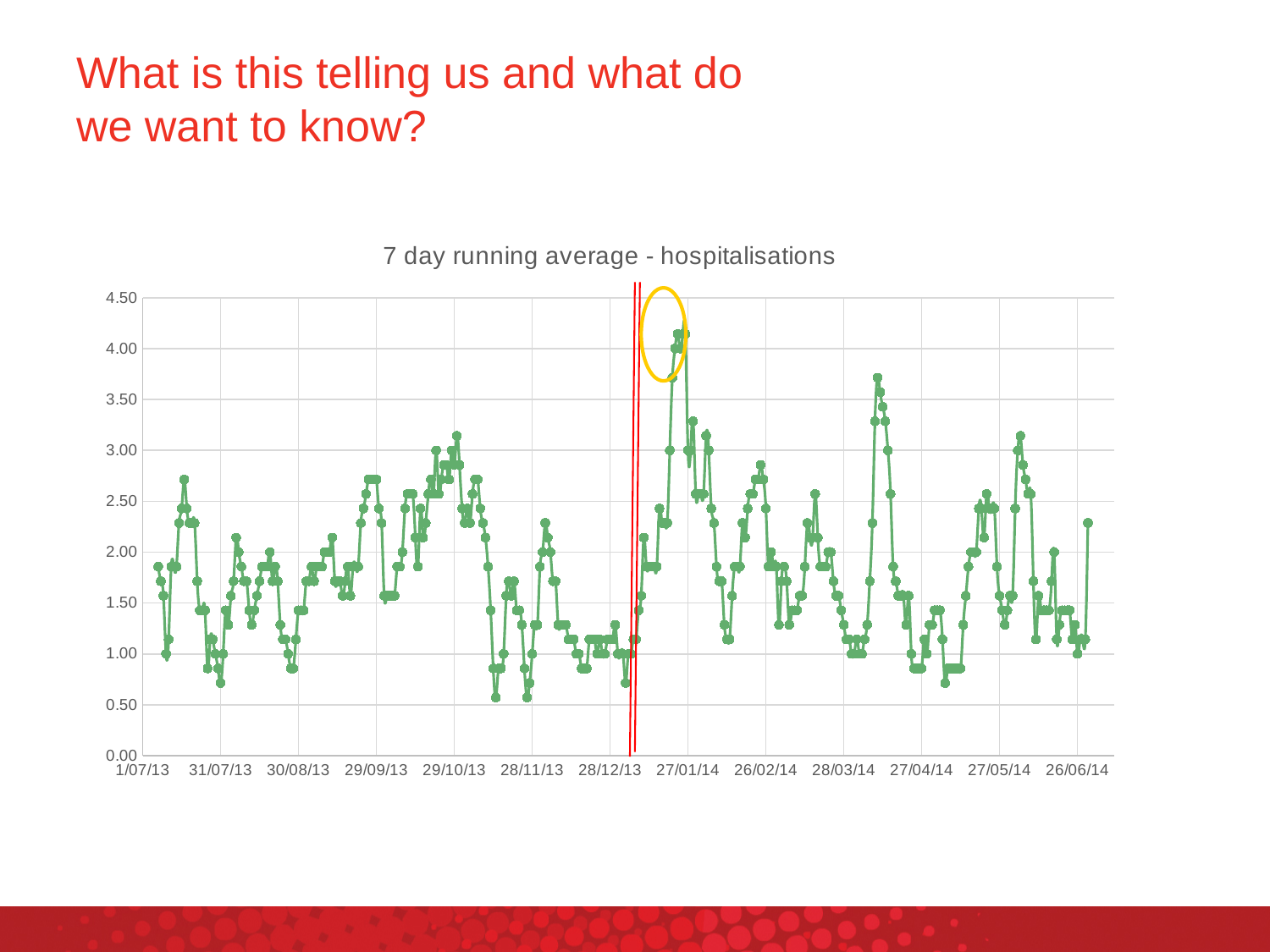
How many date labels are shown on the x axis? 13 Is the value around 27/01/14 larger or smaller than the value around 27/04/14? larger What is the title of the chart? 7 day running average - hospitalisations Is the peak value of the series (circled in yellow) greater or less than 4.00? greater Is the value around 27/04/14 greater or less than 1.50? less What is the highest value shown on the y axis? 4.50 What kind of chart is shown on the slide? Line chart Is the value at the start of the series (1/07/13) greater or less than 1.50? greater Does the series rise or fall immediately after the red vertical lines? rises Around which x-axis date does the series reach its highest value? 27/01/14